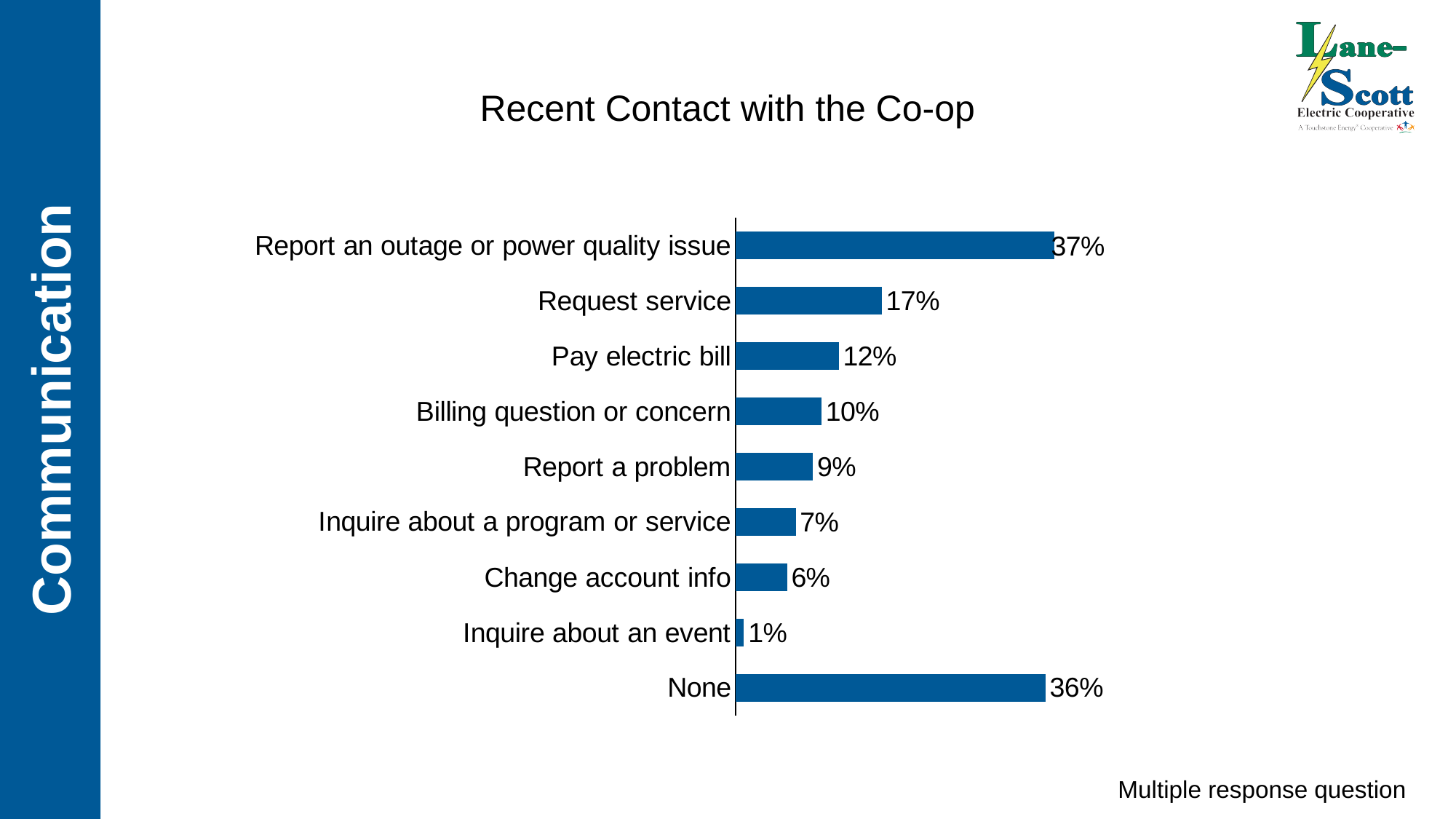
How many categories are shown in the chart? 9 Which category has the lowest value? Inquire about an event What is the difference between Request service and Pay electric bill? 5% What percentage is shown for Pay electric bill? 12% What is the value for Inquire about an event? 1% What is the difference between Report an outage or power quality issue and None? 1% What kind of chart is shown on the slide? Bar chart What is the title of the chart? Recent Contact with the Co-op Which is larger, Billing question or concern or Report a problem? Billing question or concern What is the value for Request service? 17% Which category has the highest value? Report an outage or power quality issue What percentage of respondents reported an outage or power quality issue? 37%